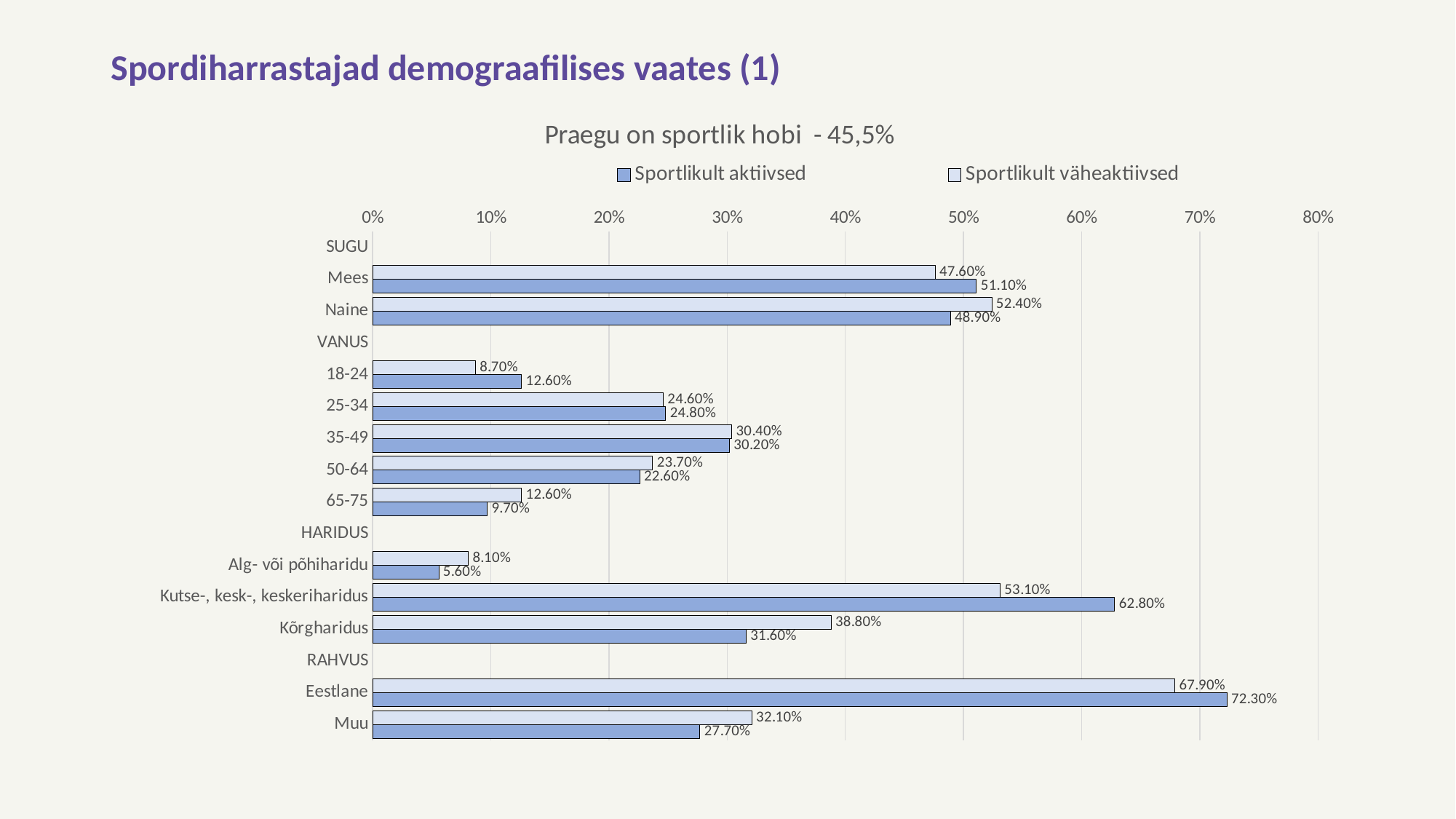
Which category has the highest value in the Sportlikult aktiivsed series? Eestlane How many series does the legend list? 2 For Naine, which series has the larger value: Sportlikult aktiivsed or Sportlikult väheaktiivsed? Sportlikult väheaktiivsed Which category has the lowest value in the Sportlikult aktiivsed series? Alg- või põhiharidu Is the Sportlikult aktiivsed value for Mees greater or less than 50%? greater What is the value for Eestlane in the Sportlikult aktiivsed series? 72.30% What kind of chart is shown on the slide? Bar chart What is the difference between the Sportlikult väheaktiivsed and Sportlikult aktiivsed values for 65-75? 2.90% What is the difference between the Sportlikult aktiivsed and Sportlikult väheaktiivsed values for Kutse-, kesk-, keskeriharidus? 9.70% What is the value for 18-24 in the Sportlikult aktiivsed series? 12.60% What is the title of the chart? Praegu on sportlik hobi - 45,5% What is the value for Kõrgharidus in the Sportlikult väheaktiivsed series? 38.80%